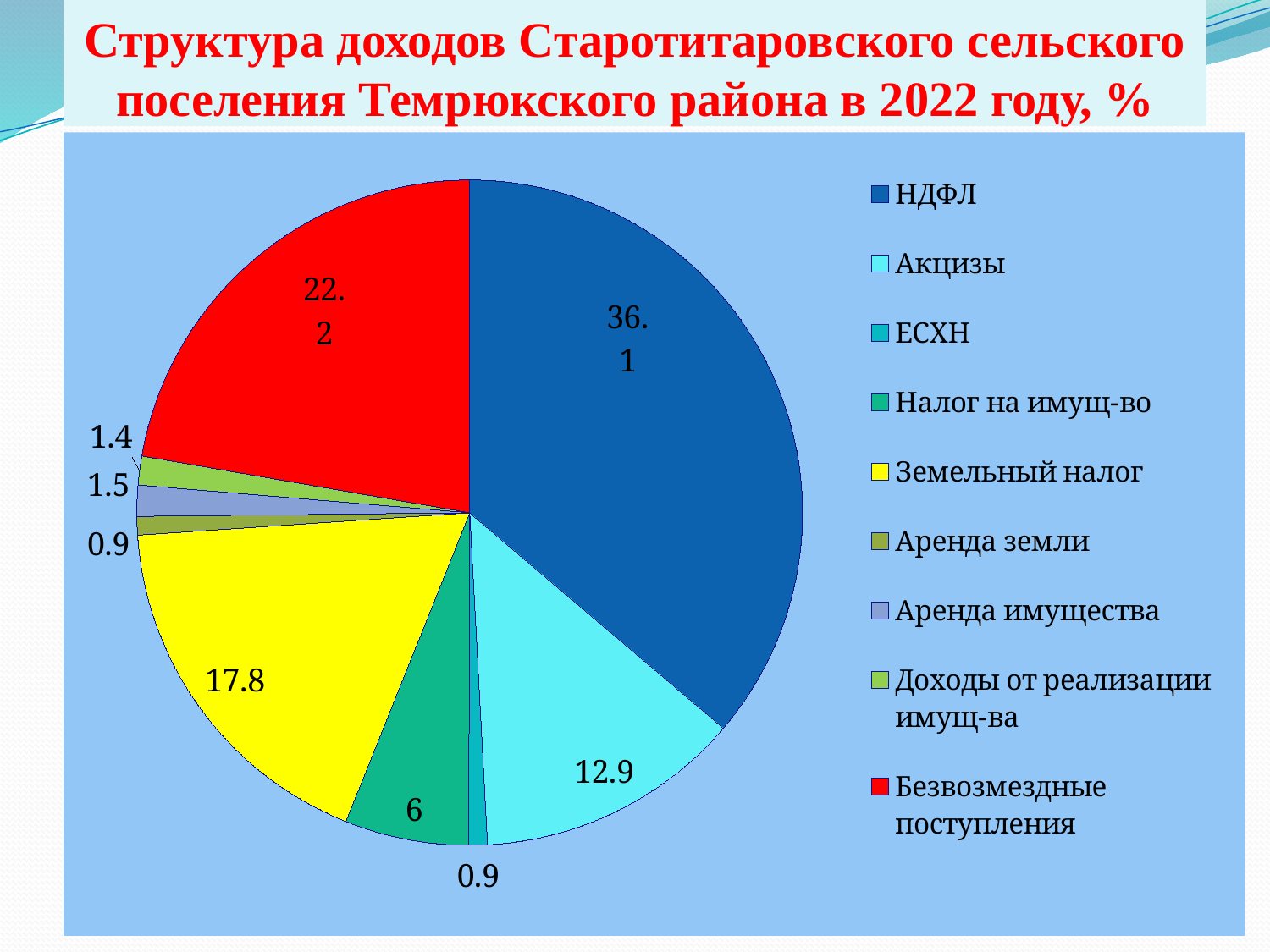
Which is larger, Земельный налог or Акцизы? Земельный налог What is the difference between the values for НДФЛ and Безвозмездные поступления? 13.9 What is the difference between the values for Земельный налог and Налог на имущ-во? 11.8 What colour is the slice for Безвозмездные поступления? red What is the value for Акцизы? 12.9 How many categories does the legend list? 9 What is the value for НДФЛ? 36.1 What is the value for Налог на имущ-во? 6 What is the value for Безвозмездные поступления? 22.2 Which category has the largest share of the pie? НДФЛ What is the value for Земельный налог? 17.8 What type of chart is shown on the slide? pie chart